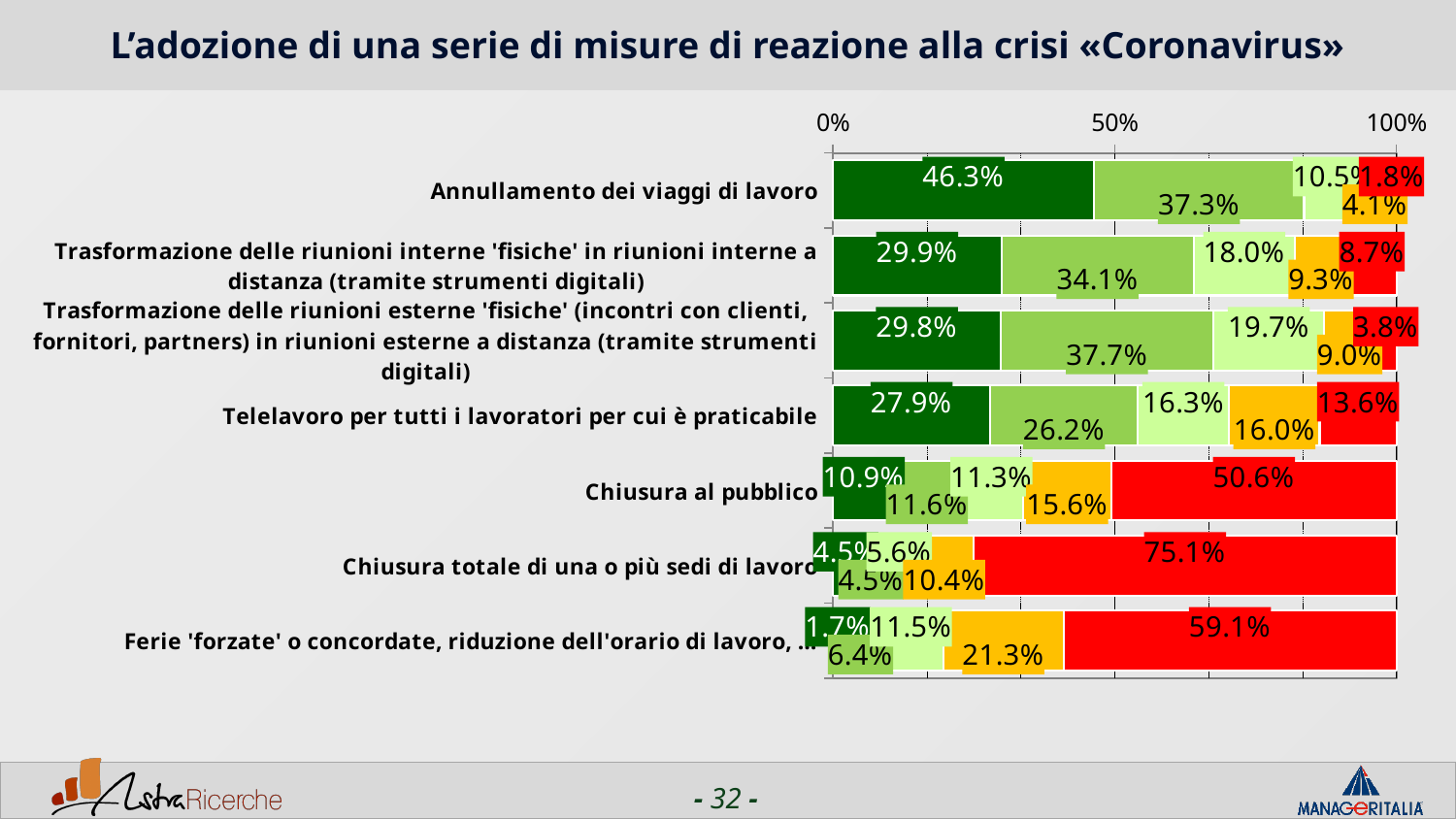
What is the value of the red segment for 'Chiusura al pubblico'? 50.6% What is the difference between the red segment of 'Chiusura totale di una o più sedi di lavoro' (75.1%) and the red segment of 'Ferie 'forzate' o concordate, riduzione dell'orario di lavoro, ...' (59.1%)? 16.0% Which category has the largest dark green (first) segment? Annullamento dei viaggi di lavoro What is the value of the orange segment for 'Telelavoro per tutti i lavoratori per cui è praticabile'? 16.0% Which is larger: the dark green segment for 'Trasformazione delle riunioni interne' (29.9%) or the dark green segment for 'Telelavoro per tutti i lavoratori per cui è praticabile' (27.9%)? Trasformazione delle riunioni interne What is the value of the red (last) segment for 'Chiusura totale di una o più sedi di lavoro'? 75.1% Which category has the largest red segment? Chiusura totale di una o più sedi di lavoro Which category has the smallest dark green (first) segment? Ferie 'forzate' o concordate, riduzione dell'orario di lavoro, ... What is the maximum value shown on the horizontal axis? 100% What kind of chart is shown on the slide? Stacked horizontal bar chart How many categories (measures) are plotted in the chart? 7 What is the value of the dark green (first) segment for 'Annullamento dei viaggi di lavoro'? 46.3%